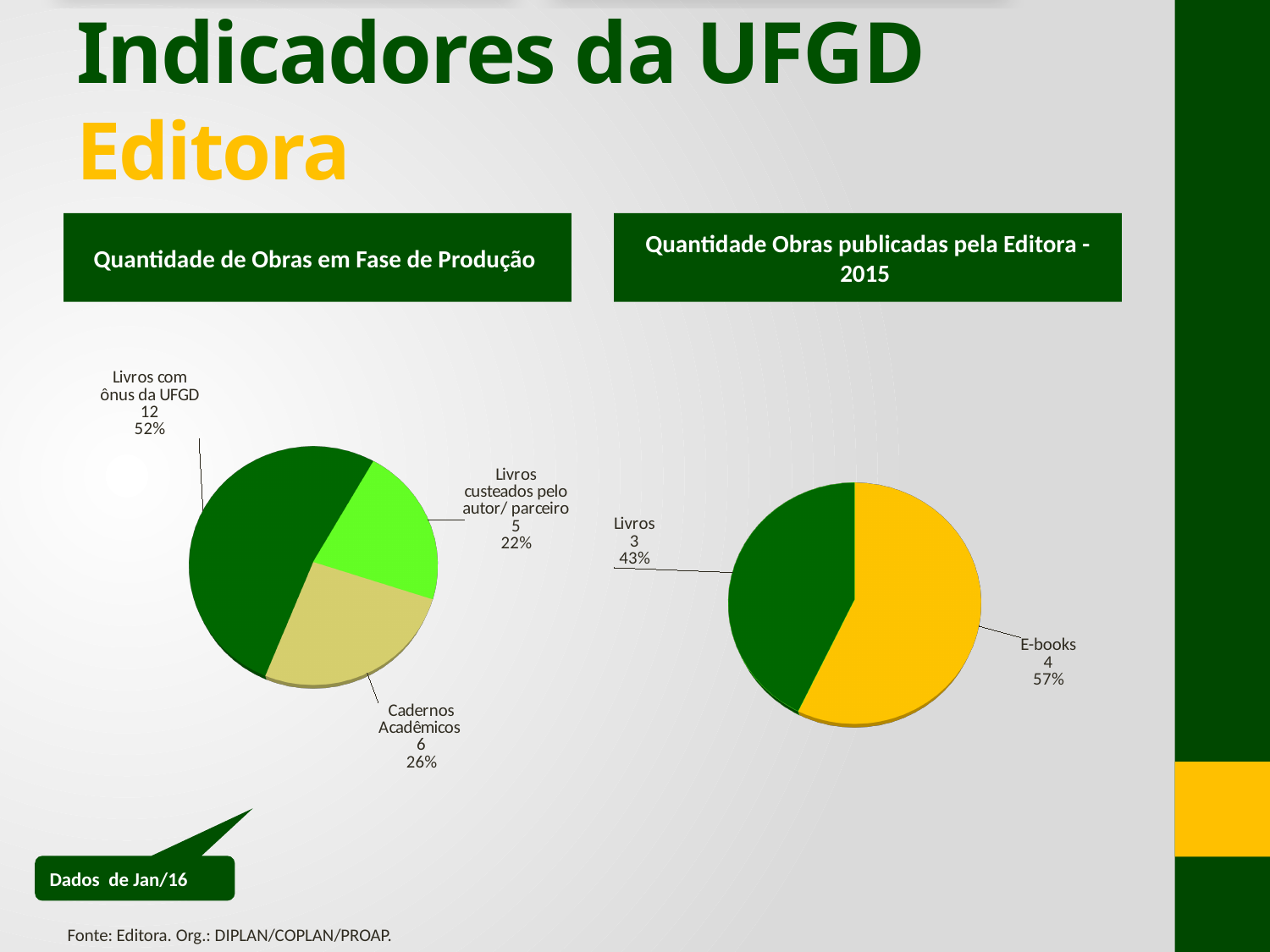
In the 'Quantidade Obras publicadas pela Editora - 2015' chart, what colour is the E-books slice? Yellow In the 'Quantidade Obras publicadas pela Editora - 2015' chart, which is larger, Livros or E-books? E-books In the 'Quantidade Obras publicadas pela Editora - 2015' chart, what is the value for E-books? 4 What kind of chart is the 'Quantidade Obras publicadas pela Editora - 2015' chart? Pie chart In the 'Quantidade de Obras em Fase de Produção' chart, what is the difference between the values for 'Livros com ônus da UFGD' and 'Cadernos Acadêmicos'? 6 In the 'Quantidade de Obras em Fase de Produção' chart, how many categories are shown? 3 In the 'Quantidade de Obras em Fase de Produção' chart, what is the value for Cadernos Acadêmicos? 6 In the 'Quantidade de Obras em Fase de Produção' chart, what percentage share does 'Livros com ônus da UFGD' have? 52% In the 'Quantidade Obras publicadas pela Editora - 2015' chart, what is the total of Livros and E-books? 7 In the 'Quantidade de Obras em Fase de Produção' chart, which category has the largest slice? Livros com ônus da UFGD In the 'Quantidade de Obras em Fase de Produção' chart, which category has the smallest slice? Livros custeados pelo autor/ parceiro In the 'Quantidade Obras publicadas pela Editora - 2015' chart, what percentage share do Livros have? 43%